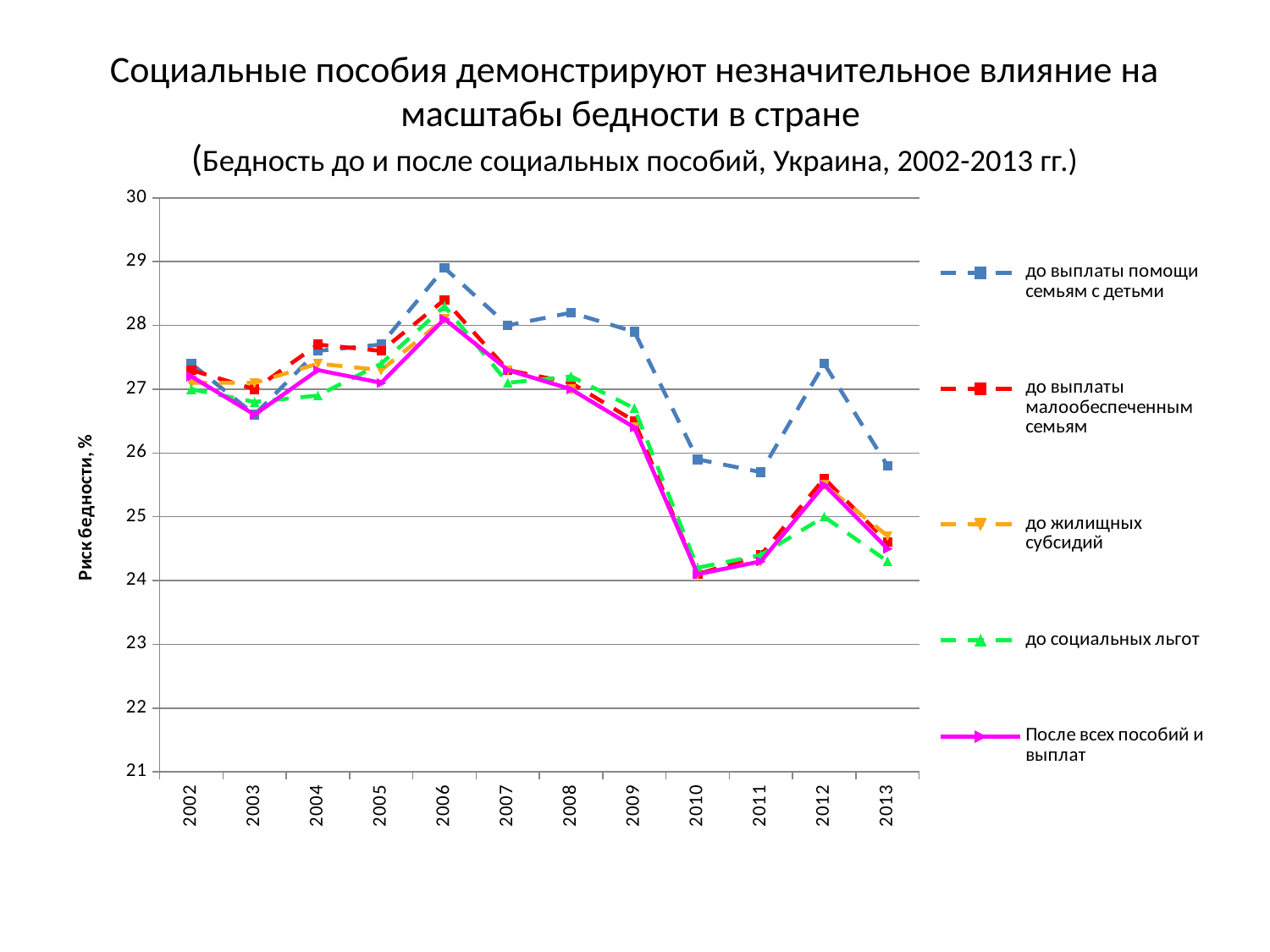
In 2010, which series has the larger value: 'до выплаты помощи семьям с детьми' or 'После всех пособий и выплат'? до выплаты помощи семьям с детьми What is the title of the vertical axis? Риск бедности, % Is the 2010 value for 'После всех пособий и выплат' greater or less than 25? less Is the 2006 value for 'до выплаты помощи семьям с детьми' greater or less than 28? greater How many years are plotted along the x axis? 12 Which legend entry is drawn as a solid magenta line? После всех пособий и выплат Is the 2012 value for 'до выплаты помощи семьям с детьми' greater or less than 27? greater Does the series 'После всех пособий и выплат' rise or fall from 2006 to 2010? fall In which year does the series 'После всех пособий и выплат' reach its lowest value? 2010 In which year does the series 'до выплаты помощи семьям с детьми' reach its highest value? 2006 What kind of chart is shown on the slide? line chart How many series does the legend list? 5